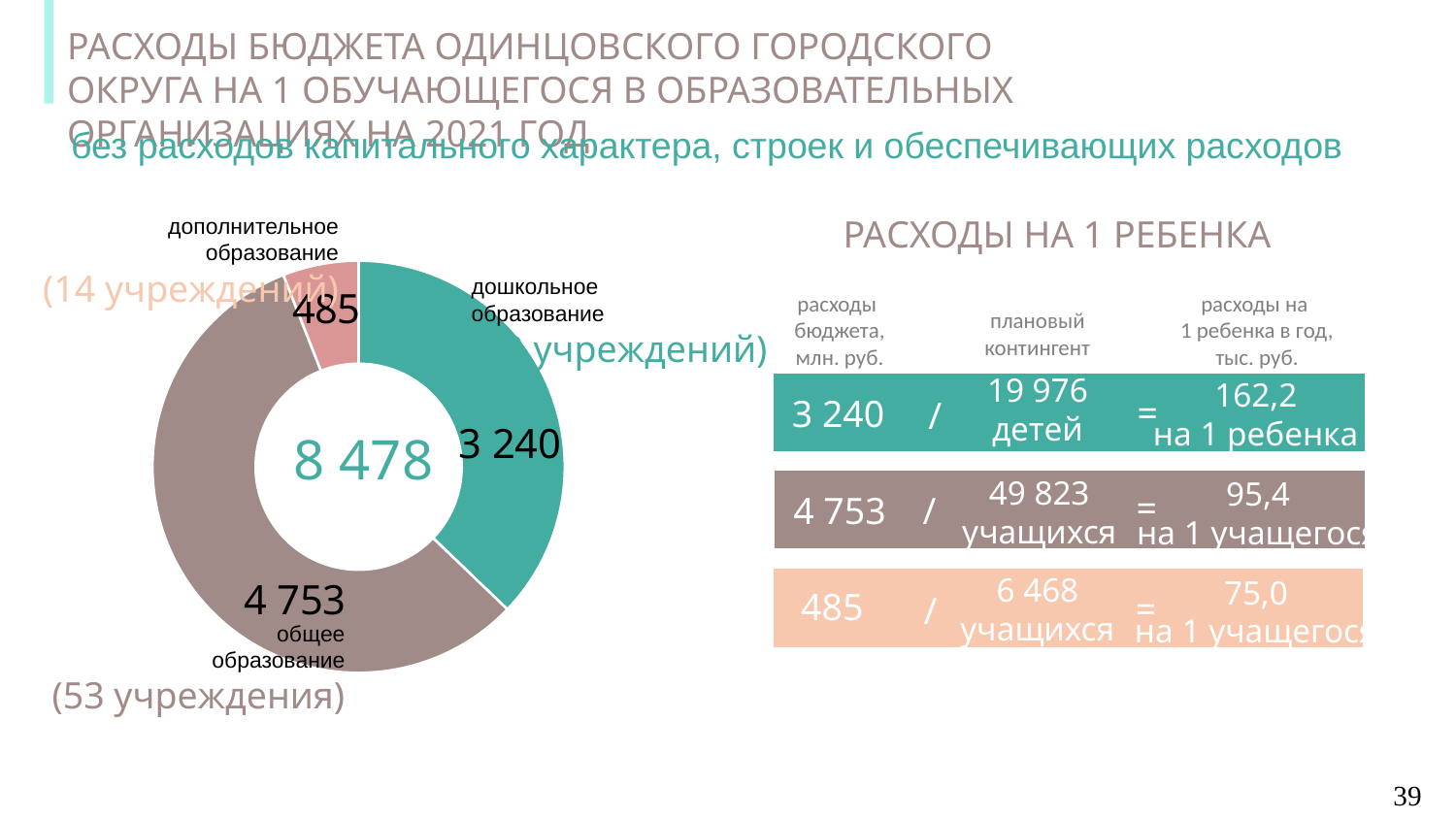
Which category has the smallest slice in the pie chart? дополнительное образование What type of chart is shown on the left of the slide? doughnut chart What is the value for общее образование in the pie chart? 4 753 What is the value for дополнительное образование in the pie chart? 485 What is the difference between the values for дошкольное образование and дополнительное образование in the pie chart? 2 755 What total is shown in the centre of the pie chart? 8 478 What is the value for дошкольное образование in the pie chart? 3 240 Which is larger in the pie chart: дошкольное образование or дополнительное образование? дошкольное образование Which category has the largest slice in the pie chart? общее образование What colour is the дошкольное образование slice in the pie chart? teal How many slices does the pie chart have? 3 What is the difference between the values for общее образование and дошкольное образование in the pie chart? 1 513